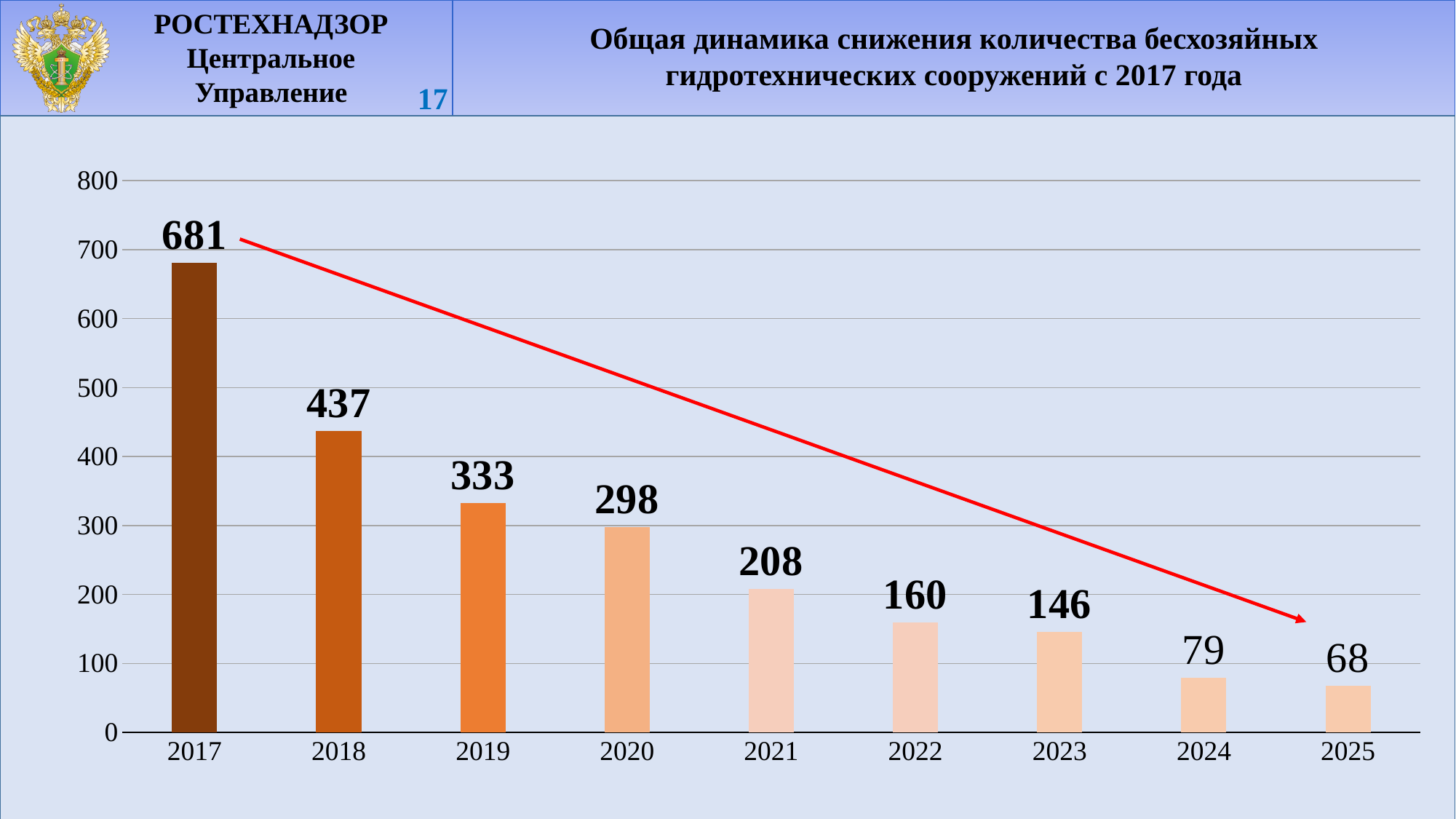
Which year has the highest value? 2017 What is the difference between the values for 2017 and 2018? 244 Do the values rise or fall from 2017 to 2025? fall Which is larger, the value for 2019 or the value for 2020? 2019 What is the difference between the values for 2024 and 2025? 11 How many years are shown on the x axis? 9 What is the value for 2025? 68 What is the value for 2017? 681 Is the value for 2022 greater or less than 200? less What kind of chart is shown on the slide? bar chart Which year has the lowest value? 2025 What is the value for 2021? 208